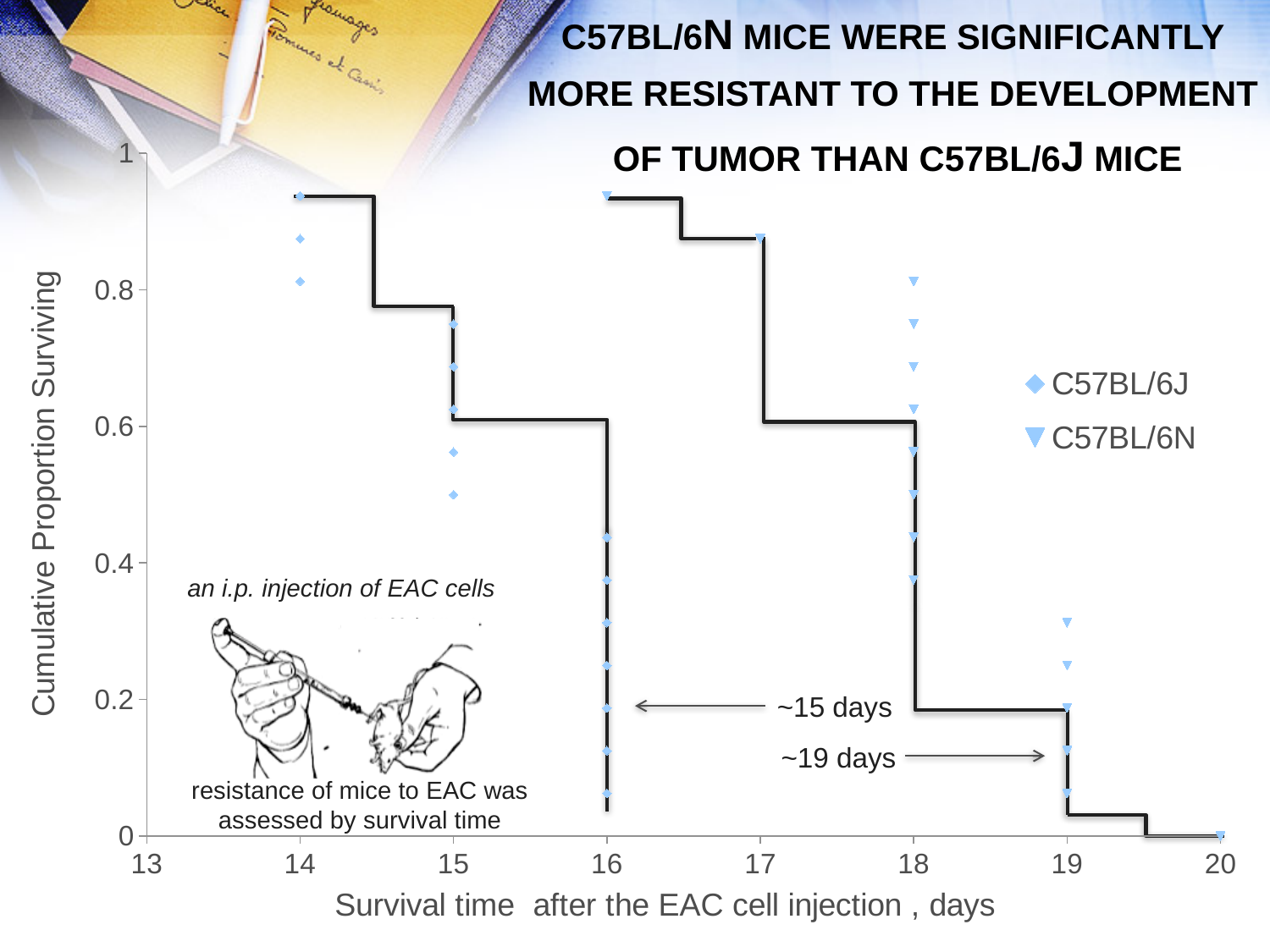
Do the survival curves rise or fall as survival time increases along the x axis? Fall Is the cumulative proportion surviving for C57BL/6N between day 16 and day 16.5 greater or less than 0.8? greater At day 17, which series has the higher cumulative proportion surviving, C57BL/6J or C57BL/6N? C57BL/6N Is the cumulative proportion surviving for C57BL/6N between day 19 and day 19.5 greater or less than 0.2? less Which series reaches a cumulative proportion surviving of 0 first? C57BL/6J What kind of chart is shown on the slide? Step (survival curve) line chart Is the cumulative proportion surviving for C57BL/6J between day 14 and day 14.5 greater or less than 0.8? greater What is the title of the x axis? Survival time after the EAC cell injection, days At what survival time does the C57BL/6N curve reach a cumulative proportion surviving of 0? 20 days How many series does the legend list? 2 Which series survives longer after the EAC cell injection? C57BL/6N What are the two series named in the legend? C57BL/6J and C57BL/6N